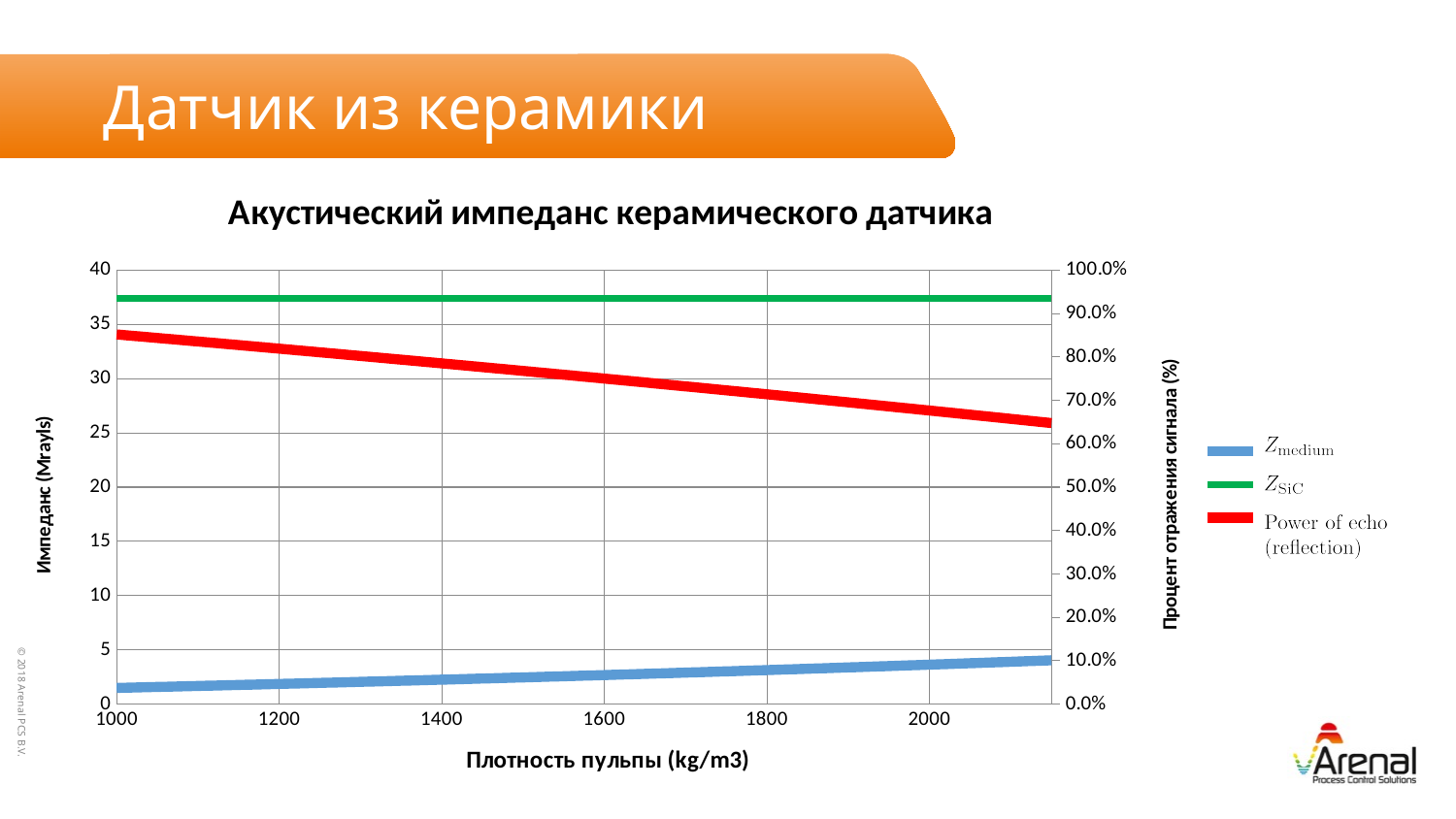
Which series has the higher impedance, Z_SiC or Z_medium? Z_SiC Does the Power of echo (reflection) line rise or fall as density increases along the x axis? fall What kind of chart is shown on the slide? line chart What is the title of the chart? Акустический импеданс керамического датчика What is the label of the x axis? Плотность пульпы (kg/m3) Does the Z_SiC line rise, fall or stay flat as density increases along the x axis? stay flat Is the impedance value for Z_medium at a density of 1000 kg/m3 greater or less than 5 Mrayls? less How many series does the legend list? 3 Is the impedance value for Z_SiC greater or less than 35 Mrayls? greater Is the Power of echo (reflection) at a density of 2000 kg/m3 greater or less than 60.0%? greater Does the Z_medium line rise or fall as density increases along the x axis? rise